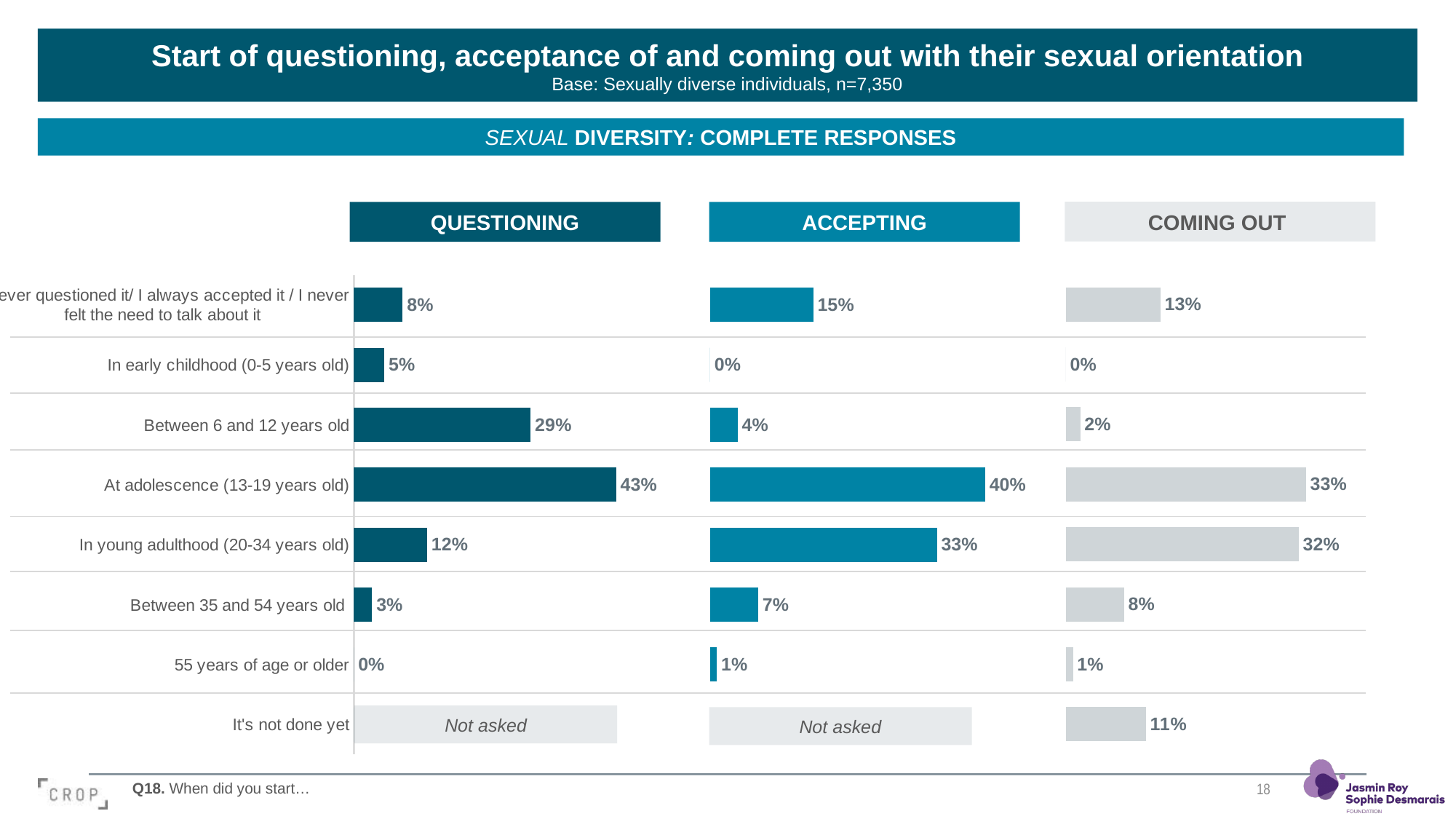
In the ACCEPTING chart, what is the value for 'Between 6 and 12 years old'? 4% What type of chart is used on this slide? Bar chart In the COMING OUT chart, what is the difference between 'At adolescence (13-19 years old)' and 'In young adulthood (20-34 years old)'? 1% Which is larger: the ACCEPTING value for 'Between 35 and 54 years old' or the COMING OUT value for 'Between 35 and 54 years old'? COMING OUT In the COMING OUT chart, what is the value for 'It's not done yet'? 11% In the QUESTIONING chart, what is the value for 'At adolescence (13-19 years old)'? 43% In the QUESTIONING chart, what is the difference between 'Between 6 and 12 years old' and 'In young adulthood (20-34 years old)'? 17% How many column headings (stages) are shown above the charts? 3 In the QUESTIONING chart, what is shown for 'It's not done yet'? Not asked In the ACCEPTING chart, what is the value for 'In young adulthood (20-34 years old)'? 33% In the ACCEPTING chart, which category has the lowest value? In early childhood (0-5 years old) In the QUESTIONING chart, which category has the highest value? At adolescence (13-19 years old)